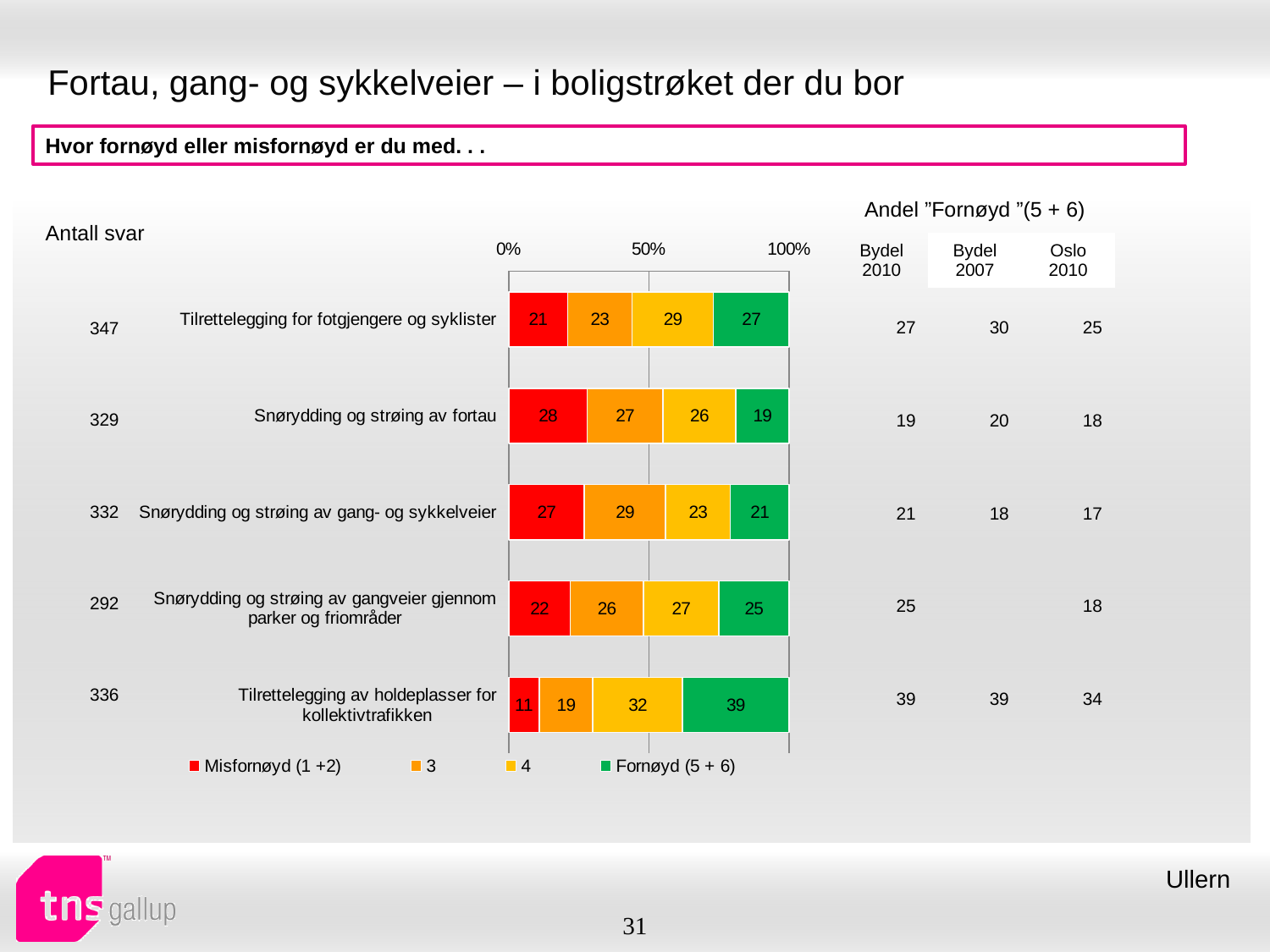
What is the total of the stacked bar for "Snørydding og strøing av gangveier gjennom parker og friområder"? 100 What colour represents the "Fornøyd (5 + 6)" series in the chart? green What is the difference between the "Fornøyd (5 + 6)" values for "Tilrettelegging av holdeplasser for kollektivtrafikken" and "Snørydding og strøing av fortau"? 20 Which category has the highest "Fornøyd (5 + 6)" value? Tilrettelegging av holdeplasser for kollektivtrafikken Which is larger: the "Misfornøyd (1 +2)" value for "Snørydding og strøing av fortau" or for "Tilrettelegging for fotgjengere og syklister"? Snørydding og strøing av fortau What is the value of "Fornøyd (5 + 6)" for "Tilrettelegging av holdeplasser for kollektivtrafikken"? 39 What is the value of series "3" for "Snørydding og strøing av gang- og sykkelveier"? 29 What is the value of "Misfornøyd (1 +2)" for "Snørydding og strøing av fortau"? 28 What kind of chart is shown on the slide? stacked bar chart Which category has the lowest "Misfornøyd (1 +2)" value? Tilrettelegging av holdeplasser for kollektivtrafikken How many categories are plotted in the chart? 5 How many series does the legend list? 4